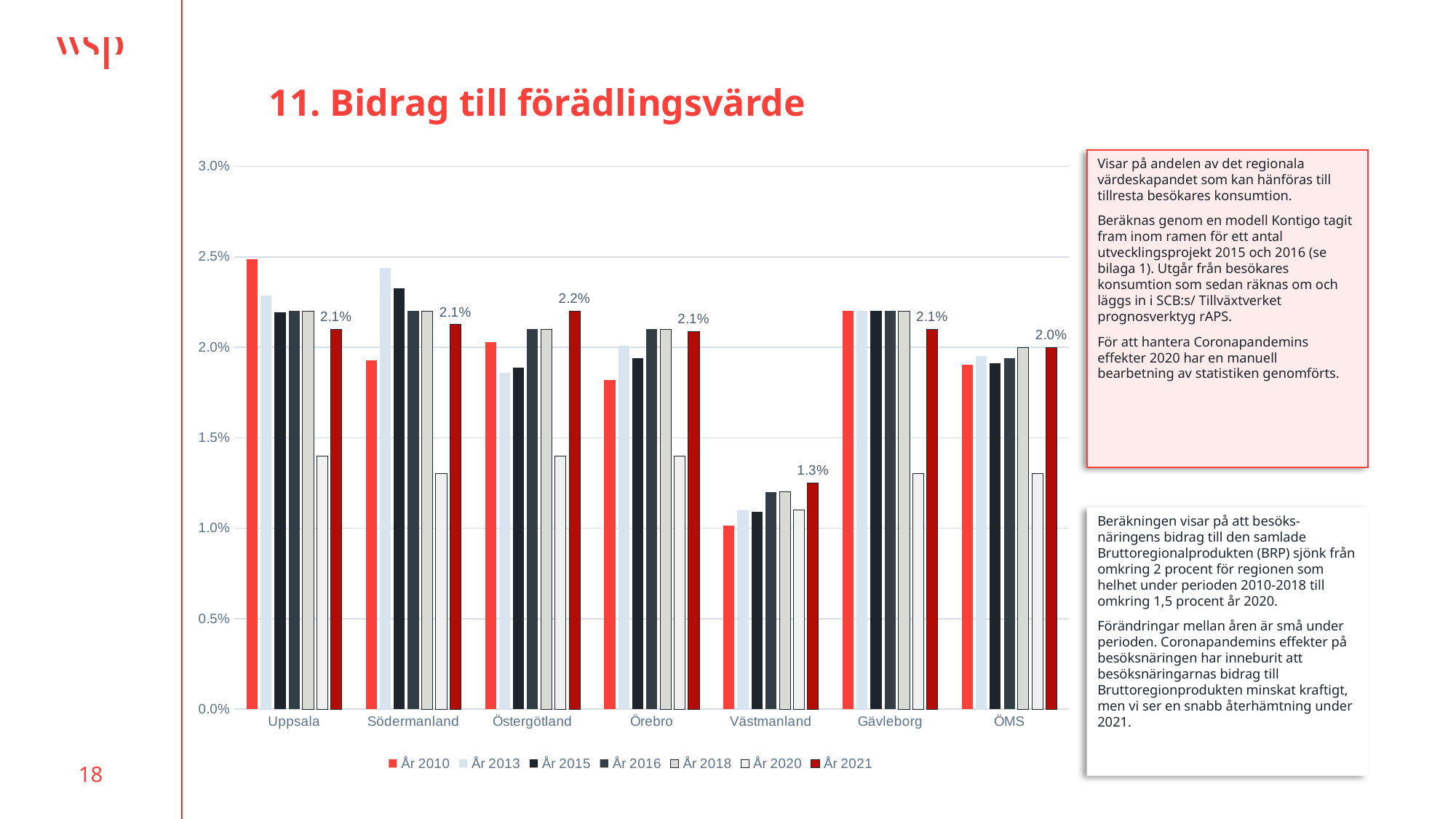
Which region has the highest value for År 2021? Östergötland What is the value for År 2021 in Östergötland? 2.2% What kind of chart is shown on the slide? Bar chart Which is larger for År 2021: Uppsala or Västmanland? Uppsala How many series does the legend list? 7 Which region has the lowest value for År 2021? Västmanland How many regions are shown on the x axis? 7 What is the value for År 2021 in Västmanland? 1.3% Is the value for År 2010 in Uppsala greater or less than 2.0%? greater Is the value for År 2010 in Västmanland greater or less than 1.5%? less What is the difference between the År 2021 values for Östergötland and Västmanland? 0.9% What is the value for År 2021 in ÖMS? 2.0%